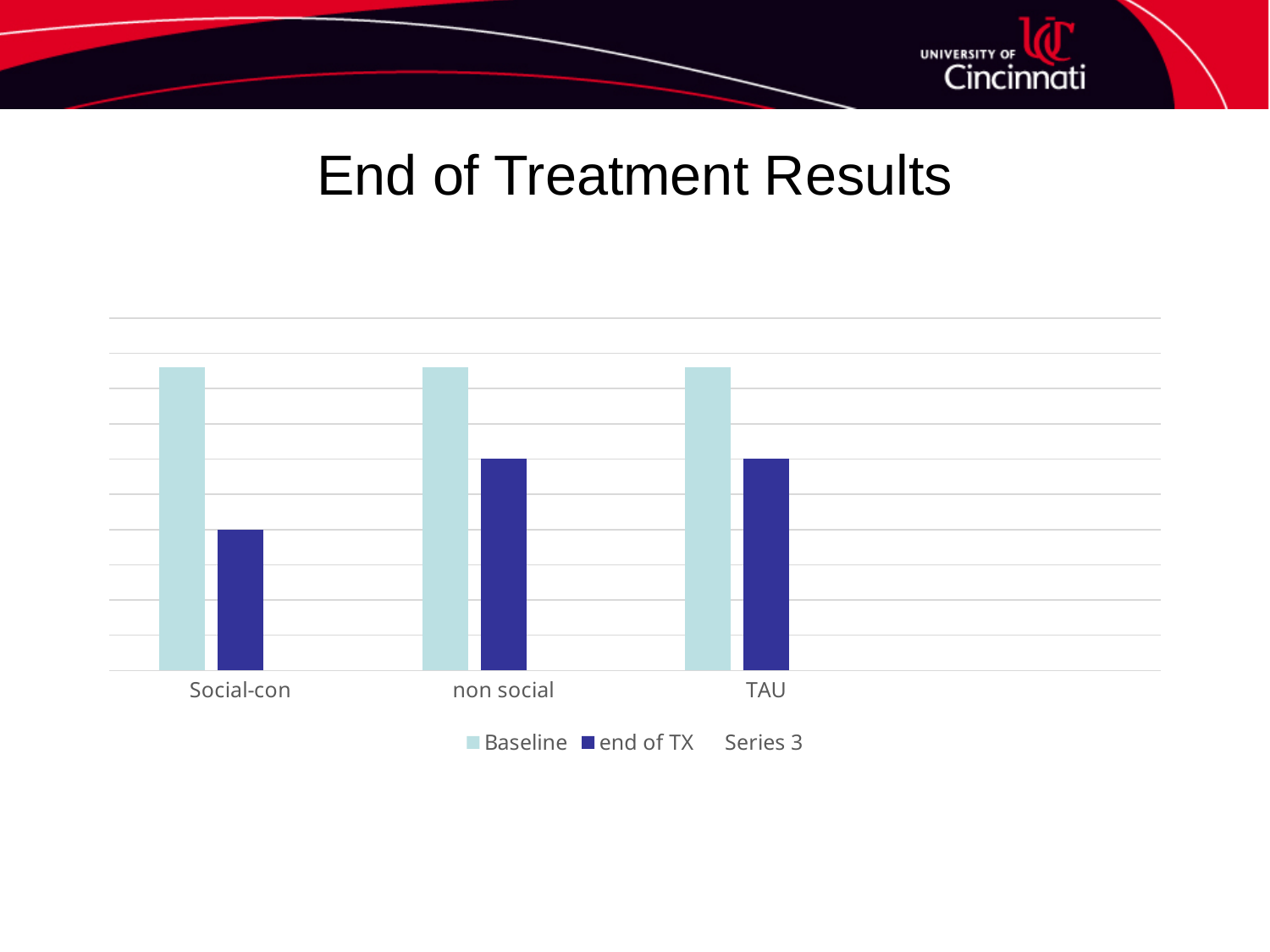
For TAU, which is larger: the Baseline value or the end of TX value? Baseline What kind of chart is shown on the slide? Bar chart For non social, which is larger: the Baseline value or the end of TX value? Baseline Which series is shown in dark blue in the chart? end of TX Which category has the lowest end of TX value? Social-con What are the names of the categories on the x axis of the chart? Social-con, non social, TAU How many series does the chart's legend list? 3 Which is larger: the end of TX value for Social-con or the end of TX value for non social? non social How many categories are shown on the x axis of the chart? 3 What is the title of the slide containing the chart? End of Treatment Results